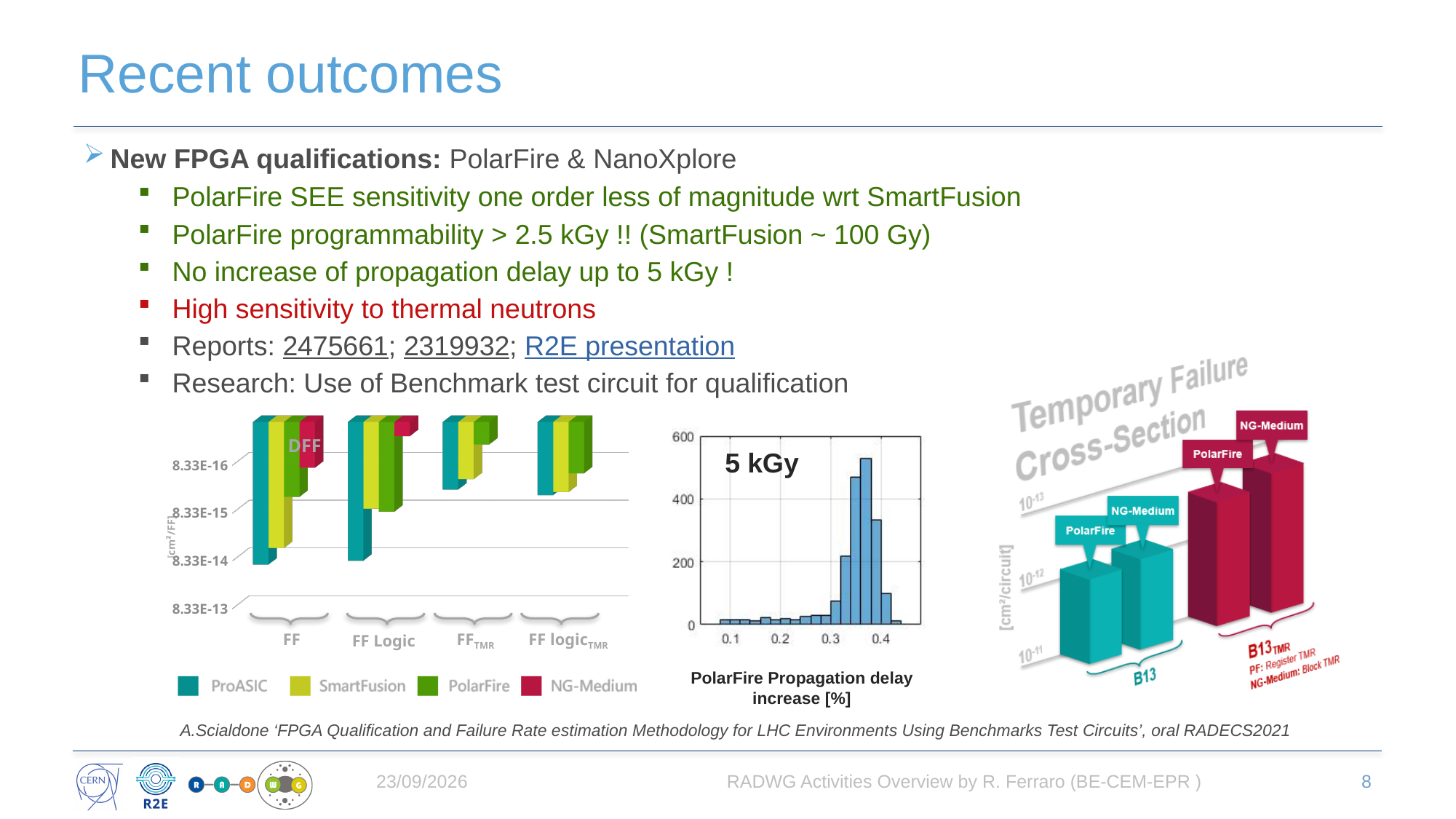
What dose is annotated on the middle histogram of PolarFire propagation delay increase? 5 kGy How many category groups are shown in the right chart titled Temporary Failure Cross-Section? 2 How many series does the legend of the left bar chart list? 4 What kind of chart is the left chart showing ProASIC, SmartFusion, PolarFire and NG-Medium? bar chart What is the x-axis label of the middle histogram? PolarFire Propagation delay increase [%] In the left bar chart, which series is shown in red? NG-Medium In the left bar chart, which series has the longest bar in the FF group? ProASIC In the right chart titled Temporary Failure Cross-Section, which group has the taller bars, B13 or B13 TMR? B13 TMR In the middle histogram, is the tallest bar greater or less than 400? greater In the middle histogram, is the bar at 0.1 greater or less than 200? less How many category groups are shown along the x axis of the left bar chart? 4 In the left bar chart, which series has the shortest bar in the FF group? NG-Medium